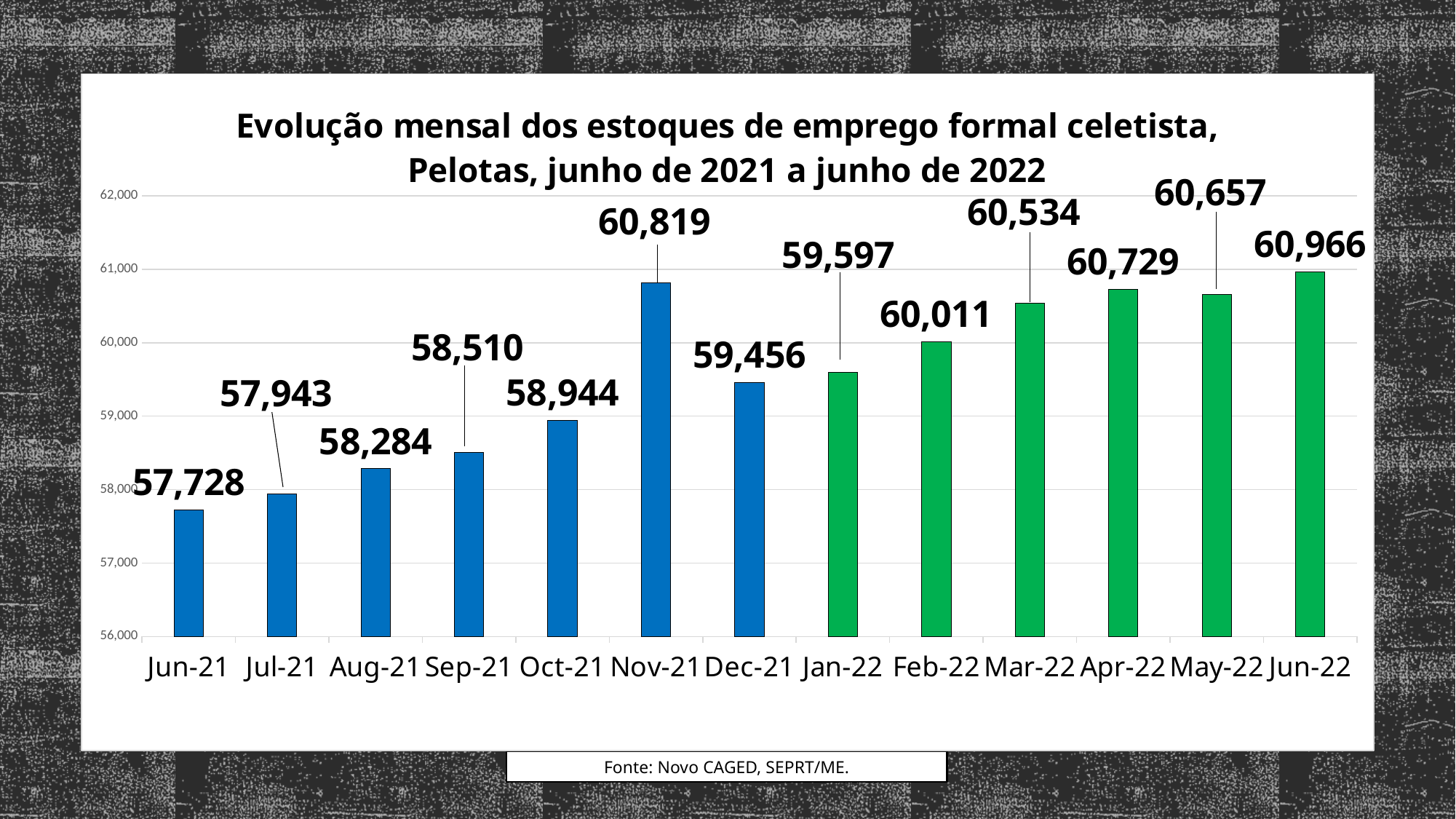
Which month has the lowest value? Jun-21 Which is larger, the value for Nov-21 or the value for Dec-21? Nov-21 What is the difference between the values for Jun-22 and Jun-21? 3,238 Is the value for Sep-21 greater or less than 59,000? less What is the difference between the values for Nov-21 and Dec-21? 1,363 What is the value for Mar-22? 60,534 Which month has the highest value? Jun-22 What is the value for Nov-21? 60,819 What is the value for Jun-21? 57,728 What kind of chart is shown on the slide? Bar chart What colour are the bars for the 2022 months? Green How many months are shown on the x axis? 13